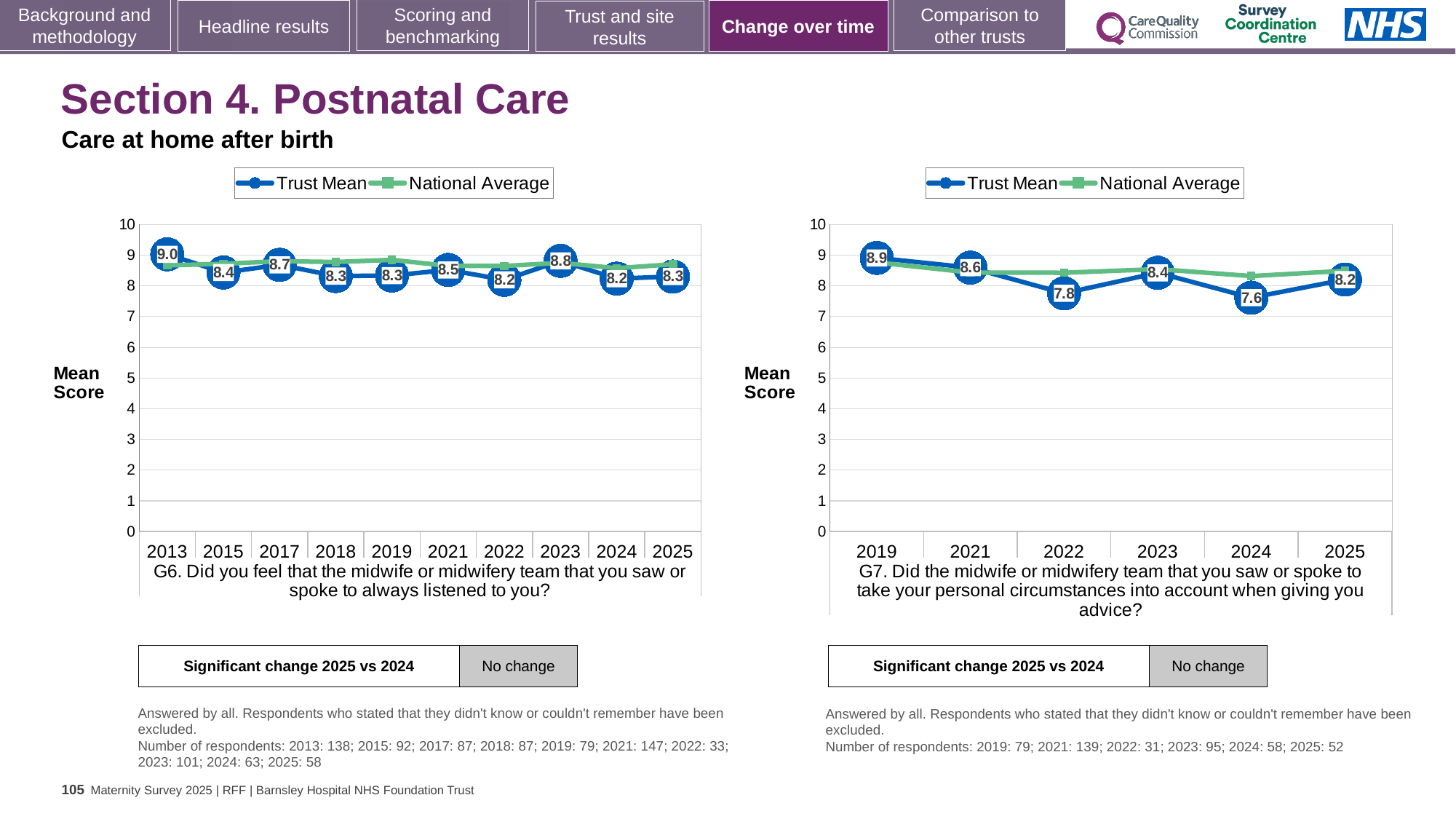
In the G7 chart on the right, which year has the highest Trust Mean? 2019 In the G7 chart on the right, which year has the lowest Trust Mean? 2024 How many series does the legend of the G6 chart on the left list? 2 In the G6 chart on the left, how many years are plotted on the x axis? 10 In the G6 chart on the left, what is the difference between the Trust Mean in 2013 and in 2025? 0.7 In the G6 chart on the left, what is the Trust Mean for 2013? 9.0 In the G6 chart on the left, which year has the highest Trust Mean? 2013 In the G7 chart on the right, what is the difference between the Trust Mean in 2019 and in 2024? 1.3 In the G7 chart on the right, what is the Trust Mean for 2022? 7.8 In the G6 chart on the left, what is the Trust Mean for 2023? 8.8 In the G7 chart on the right, is the Trust Mean higher in 2023 or in 2024? 2023 In the G7 chart on the right, is the National Average for 2024 greater or less than 7? greater